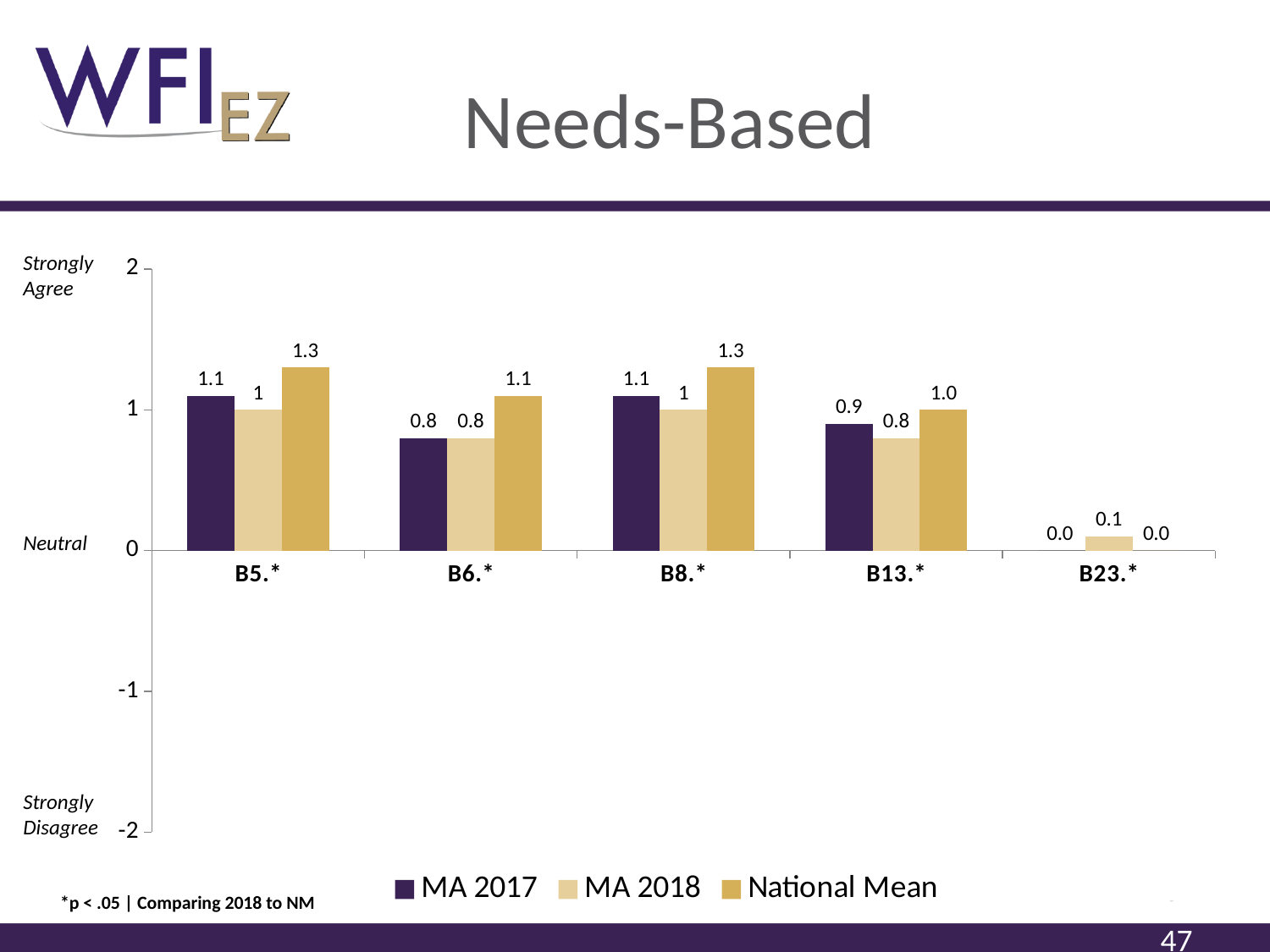
What is the MA 2017 value for B6.*? 0.8 How many categories are shown on the x axis? 5 What kind of chart is shown on the slide? Bar chart Which category has the lowest National Mean value? B23.* What is the MA 2018 value for B23.*? 0.1 What is the title of the slide? Needs-Based What is the difference between the National Mean and MA 2017 values for B8.*? 0.2 What label is shown at the top of the y axis at the value 2? Strongly Agree What is the MA 2018 value for B13.*? 0.8 How many series does the legend list? 3 Which is larger for B13.*, the MA 2017 value or the National Mean value? National Mean What is the National Mean value for B5.*? 1.3